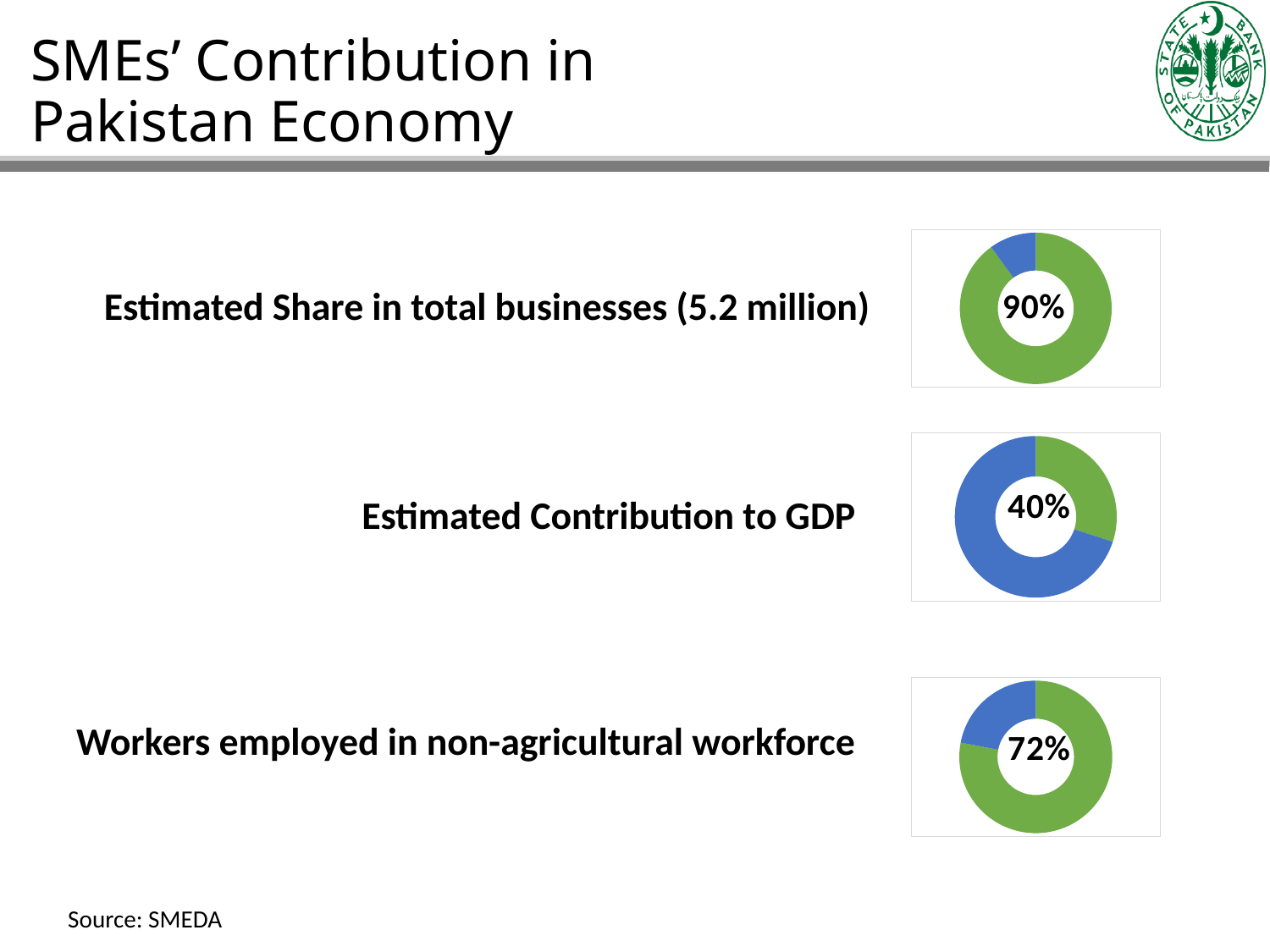
Which of the three indicators on the slide shows the lowest percentage? Estimated Contribution to GDP How many doughnut charts are shown on the slide? 3 In the doughnut chart next to "Workers employed in non-agricultural workforce", what percentage is printed in the centre? 72% What is the difference in percentage points between the "Workers employed in non-agricultural workforce" chart and the "Estimated Contribution to GDP" chart? 32 percentage points Which of the three indicators on the slide shows the highest percentage? Estimated Share in total businesses (5.2 million) What kind of chart is used to show each of the three percentages on the slide? Doughnut (pie) chart Which is larger: the percentage for "Estimated Contribution to GDP" or the percentage for "Workers employed in non-agricultural workforce"? Workers employed in non-agricultural workforce What is the difference in percentage points between the "Estimated Share in total businesses" chart and the "Estimated Contribution to GDP" chart? 50 percentage points In the "Estimated Contribution to GDP" doughnut chart, which colour is the larger slice? Blue In the doughnut chart next to "Estimated Contribution to GDP", what percentage is printed in the centre? 40% In the doughnut chart next to "Estimated Share in total businesses (5.2 million)", what percentage is printed in the centre? 90%